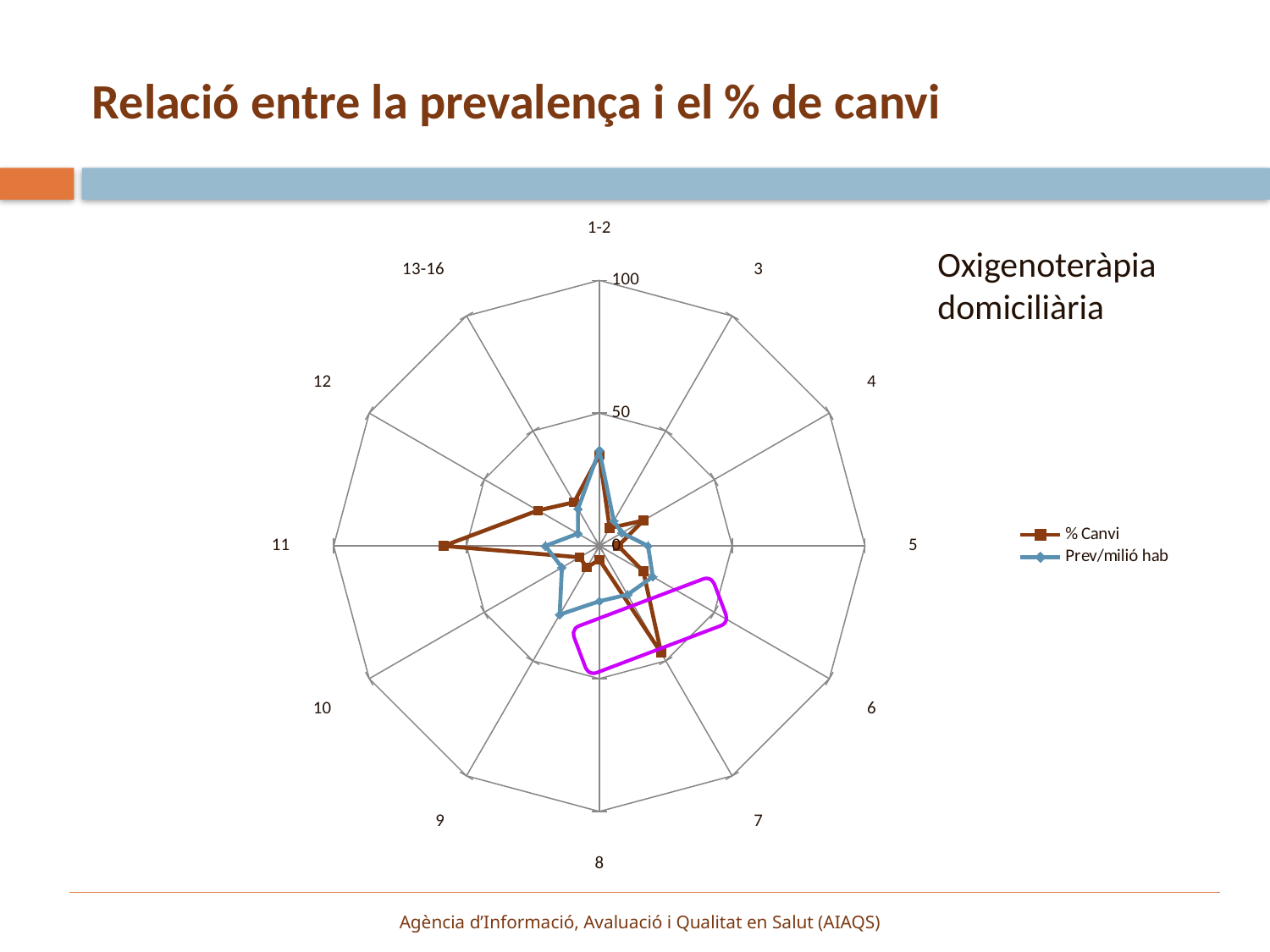
Is the Prev/milió hab value for category 11 greater or less than 50? less What is the highest value shown on the radial axis of the chart? 100 Which is larger: the % Canvi value for category 11 or the % Canvi value for category 1-2? Category 11 Is the % Canvi value for category 5 greater or less than 50? less How many series does the legend list? 2 What are the two series named in the legend? % Canvi and Prev/milió hab How many categories (axes) does the radar chart have? 12 Is the % Canvi value for category 11 greater or less than 50? greater What kind of chart is shown on the slide? Radar chart Which is larger: the Prev/milió hab value for category 1-2 or for category 5? Category 1-2 For which category does the % Canvi series reach its highest value? 11